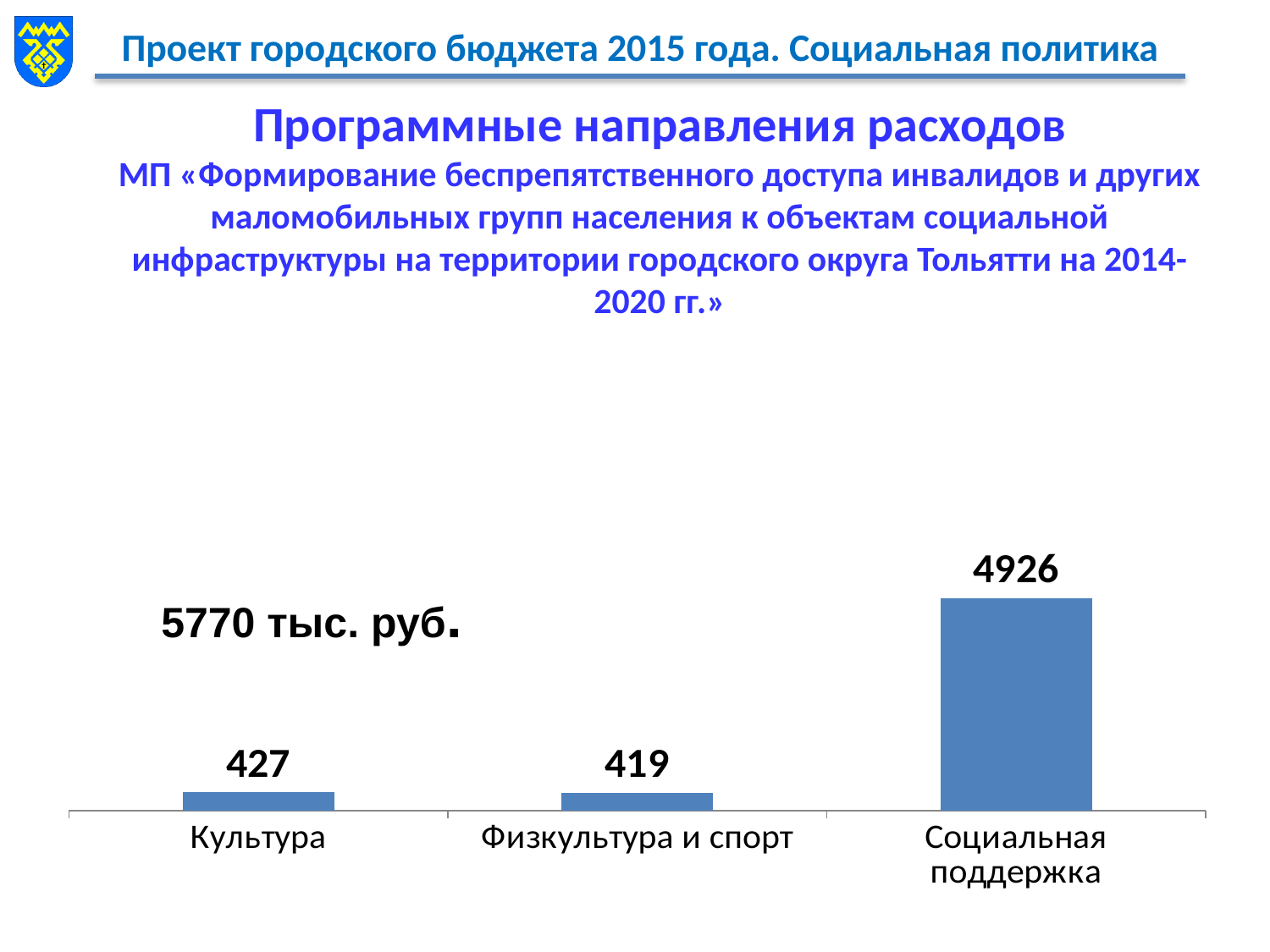
Which is larger, the value for Социальная поддержка or the value for Физкультура и спорт? Социальная поддержка What total amount in thousand rubles is printed next to the chart? 5770 тыс. руб. What is the value for Культура? 427 How many categories are shown in the chart? 3 What is the total of the three values shown in the chart? 5772 Which category has the highest value? Социальная поддержка What is the value for Социальная поддержка? 4926 What is the difference between the values for Культура and Физкультура и спорт? 8 What colour are the bars in the chart? blue What is the difference between the values for Социальная поддержка and Культура? 4499 What is the value for Физкультура и спорт? 419 What kind of chart is shown on the slide? bar chart